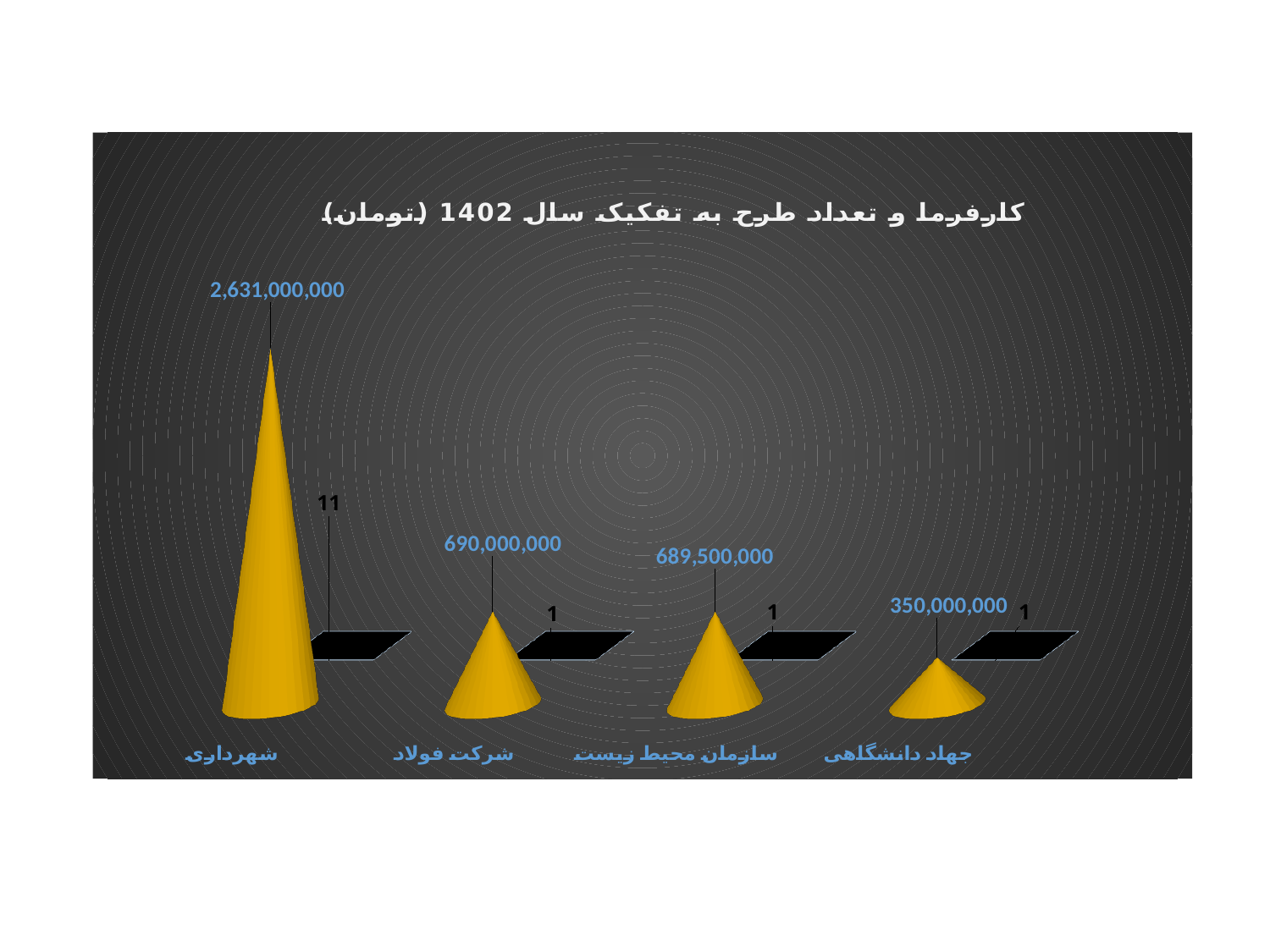
How many projects are shown for شرکت فولاد? 1 How many categories are shown on the x axis? 4 Which category has the lowest amount? جهاد دانشگاهی What is the amount value shown for شهرداری? 2,631,000,000 What is the amount value shown for شرکت فولاد? 690,000,000 What is the amount value shown for جهاد دانشگاهی? 350,000,000 What is the difference between the amounts for شرکت فولاد and سازمان محیط زیست? 500,000 What is the difference between the amounts for شهرداری and شرکت فولاد? 1,941,000,000 What is the amount value shown for سازمان محیط زیست? 689,500,000 Which category has the highest amount? شهرداری How many projects are shown for شهرداری? 11 What is the title of the chart? کارفرما و تعداد طرح به تفکیک سال 1402 (تومان)